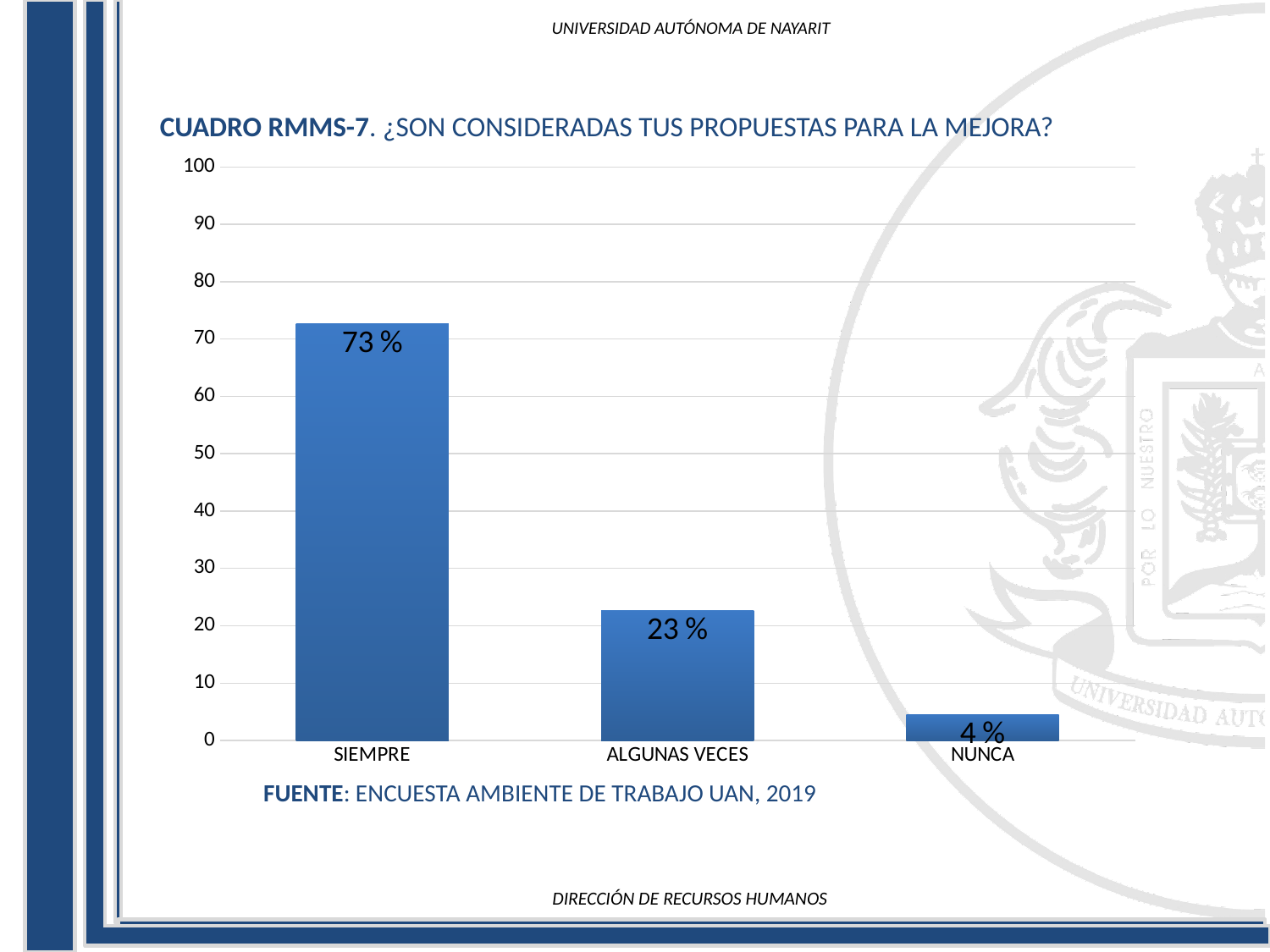
What kind of chart is shown on the slide? bar chart What is the value for SIEMPRE? 73 % Is the value for SIEMPRE greater or less than 60? greater What is the value for ALGUNAS VECES? 23 % Which is larger, the value for ALGUNAS VECES or the value for NUNCA? ALGUNAS VECES What is the difference between the values for SIEMPRE and ALGUNAS VECES? 50 % What is the value for NUNCA? 4 % Which category has the highest value? SIEMPRE How many categories are shown on the x axis? 3 Which category has the lowest value? NUNCA What is the difference between the values for ALGUNAS VECES and NUNCA? 19 % What is the source cited below the chart? ENCUESTA AMBIENTE DE TRABAJO UAN, 2019